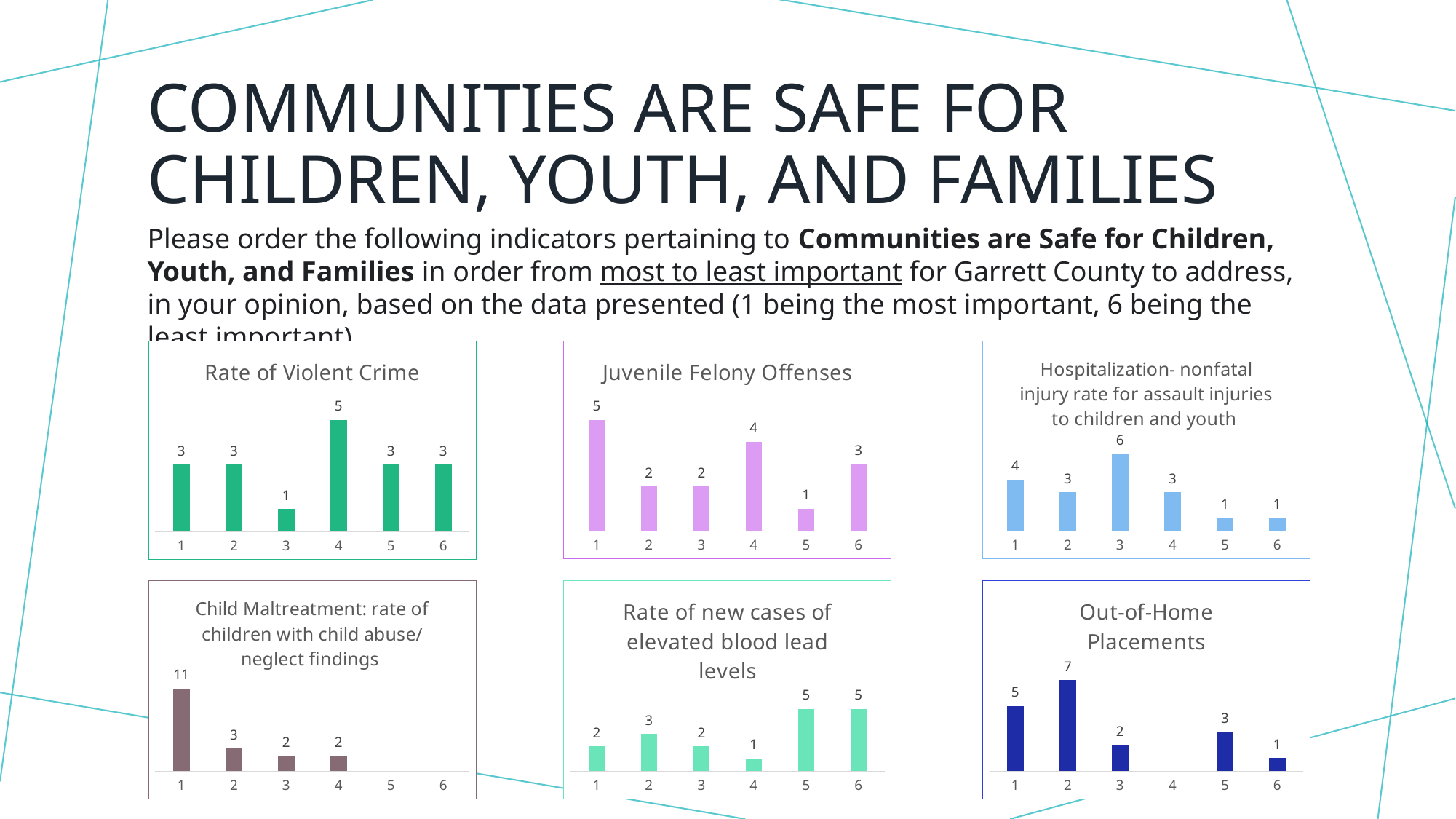
In the 'Juvenile Felony Offenses' chart, what is the value for category 1? 5 In the 'Rate of Violent Crime' chart, what is the value for category 4? 5 In the 'Out-of-Home Placements' chart, what is the difference between the values for category 2 and category 6? 6 In the 'Hospitalization- nonfatal injury rate for assault injuries to children and youth' chart, which category has the highest value? 3 In the 'Rate of Violent Crime' chart, which category has the lowest value? 3 In the 'Child Maltreatment: rate of children with child abuse/ neglect findings' chart, which is larger, the value for category 2 or category 3? category 2 In the 'Child Maltreatment: rate of children with child abuse/ neglect findings' chart, what is the value for category 1? 11 In the 'Hospitalization- nonfatal injury rate for assault injuries to children and youth' chart, what is the value for category 1? 4 In the 'Juvenile Felony Offenses' chart, what is the difference between the values for category 1 and category 5? 4 In the 'Out-of-Home Placements' chart, which category has the highest value? 2 What kind of chart is the 'Out-of-Home Placements' chart? bar chart In the 'Rate of new cases of elevated blood lead levels' chart, what is the value for category 4? 1